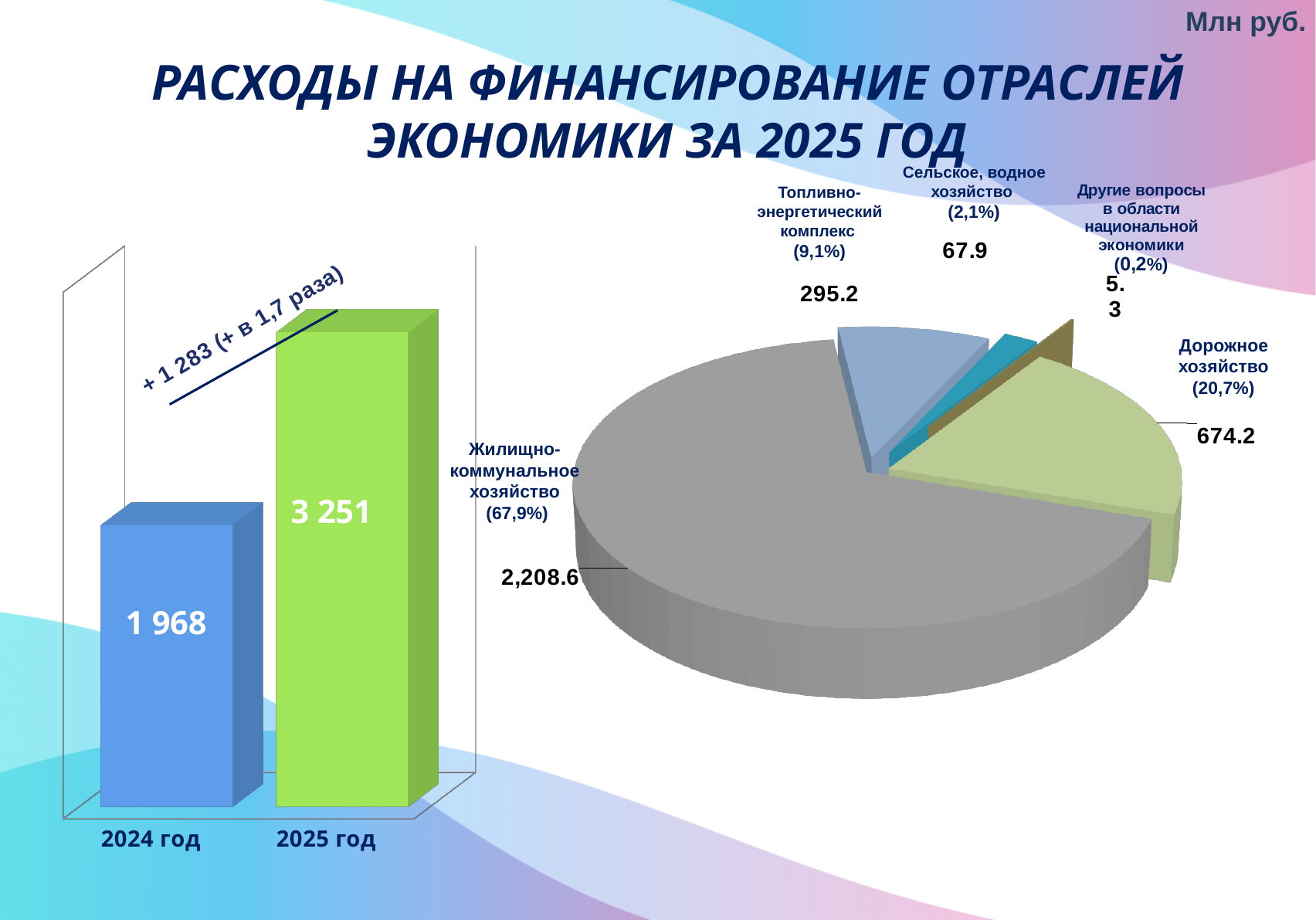
In the pie chart on the right, which category has the largest slice? Жилищно-коммунальное хозяйство In the pie chart on the right, which category has the smallest slice? Другие вопросы в области национальной экономики In the pie chart on the right, what is the value for Топливно-энергетический комплекс? 295.2 In the bar chart on the left, what is the difference between the 2025 год and 2024 год values? 1 283 In the bar chart on the left, which year has the larger value, 2024 год or 2025 год? 2025 год In the bar chart on the left, how many bars are shown? 2 In the pie chart on the right, how many slices are there? 5 In the pie chart on the right, what is the value for Дорожное хозяйство? 674.2 In the bar chart on the left, what is the value for 2024 год? 1 968 In the bar chart on the left, what is the value for 2025 год? 3 251 In the pie chart on the right, what share does Жилищно-коммунальное хозяйство have? 67,9% What kind of chart is shown on the left side of the slide? Bar chart